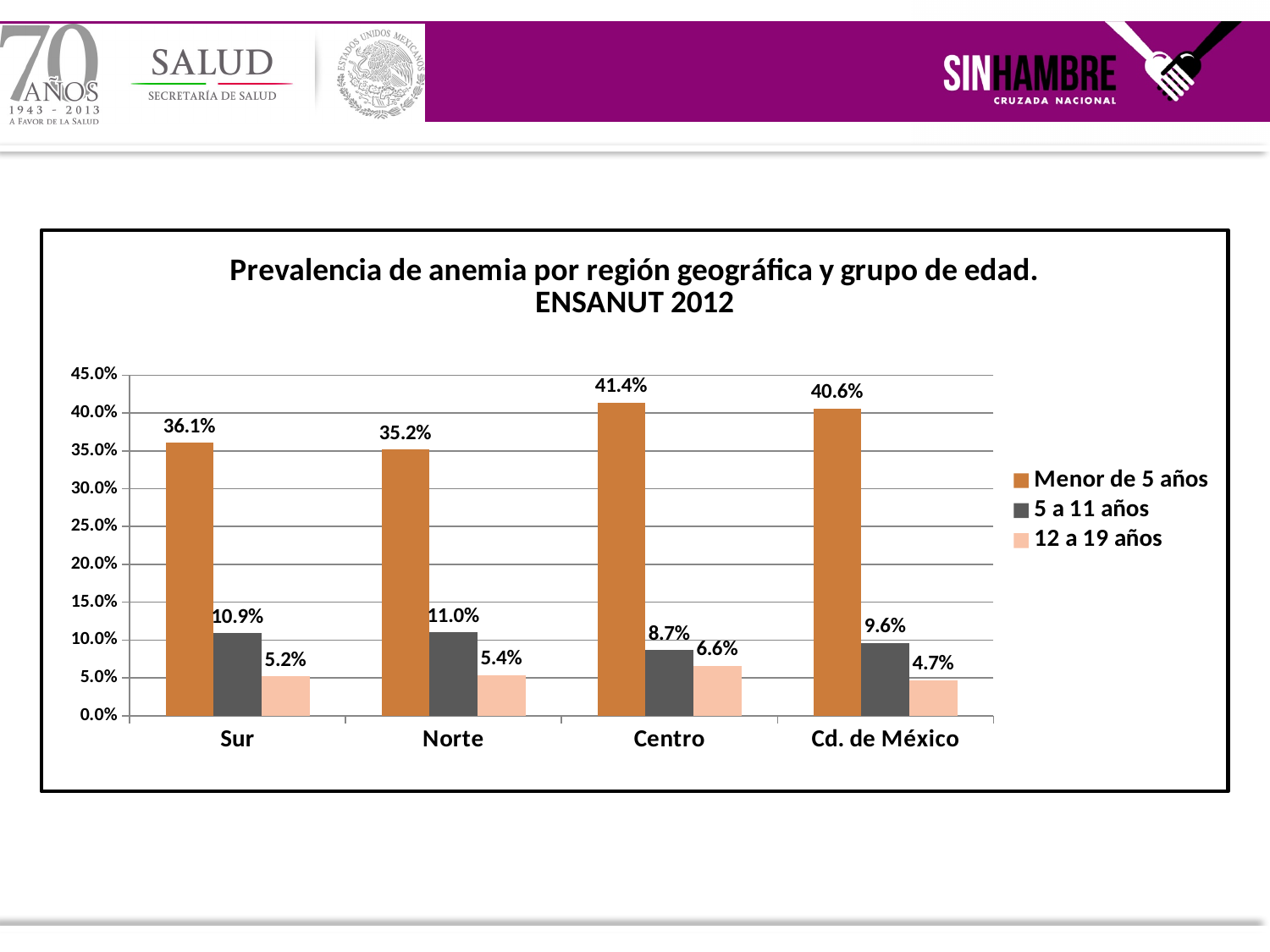
Which region has the lowest value for 12 a 19 años? Cd. de México How many regions are shown on the x axis? 4 Which is larger: the 5 a 11 años value for Sur or for Centro? Sur What kind of chart is shown on the slide? bar chart How many series does the legend list? 3 What is the value for Menor de 5 años in the Centro region? 41.4% What is the value for 12 a 19 años in Cd. de México? 4.7% Which region has the highest value for Menor de 5 años? Centro What is the title of the chart? Prevalencia de anemia por región geográfica y grupo de edad. ENSANUT 2012 What is the value for 5 a 11 años in the Norte region? 11.0% What is the difference between the Menor de 5 años values for Centro and Sur? 5.3% Is the value for Menor de 5 años in Norte greater or less than 40.0%? less